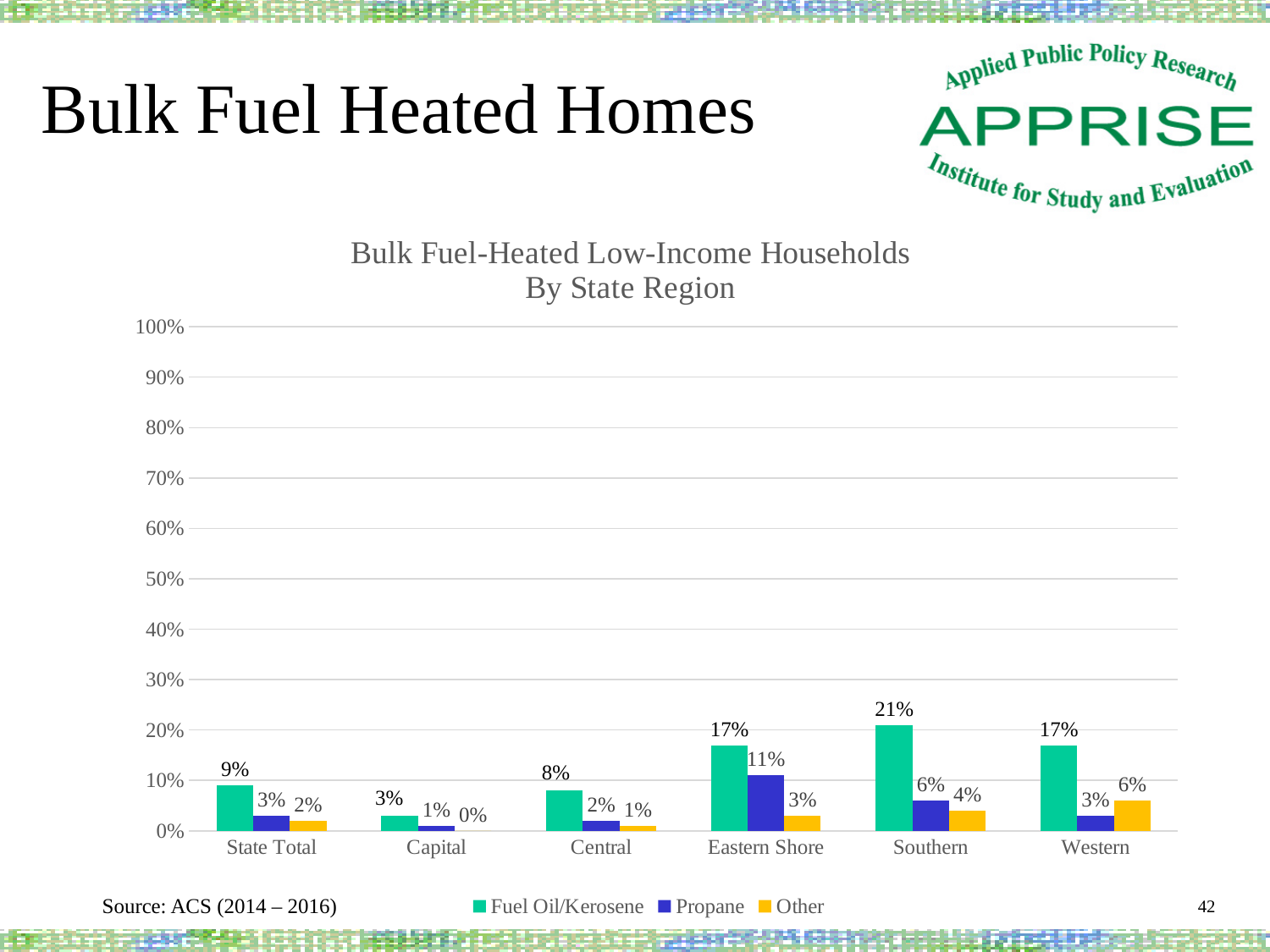
Which region has the lowest Fuel Oil/Kerosene value? Capital What is the Propane value for the Eastern Shore region? 11% How many series does the legend list? 3 What is the difference between the Fuel Oil/Kerosene values for Southern and Central? 13% What is the Fuel Oil/Kerosene value for State Total? 9% Which is larger, the Propane value for Eastern Shore or the Propane value for Southern? Eastern Shore How many regions (categories) are shown on the x axis? 6 What is the Other value for the Western region? 6% What is the Fuel Oil/Kerosene value for the Southern region? 21% What is the title of the chart? Bulk Fuel-Heated Low-Income Households By State Region Which region has the highest Fuel Oil/Kerosene value? Southern What kind of chart is shown on the slide? Bar chart